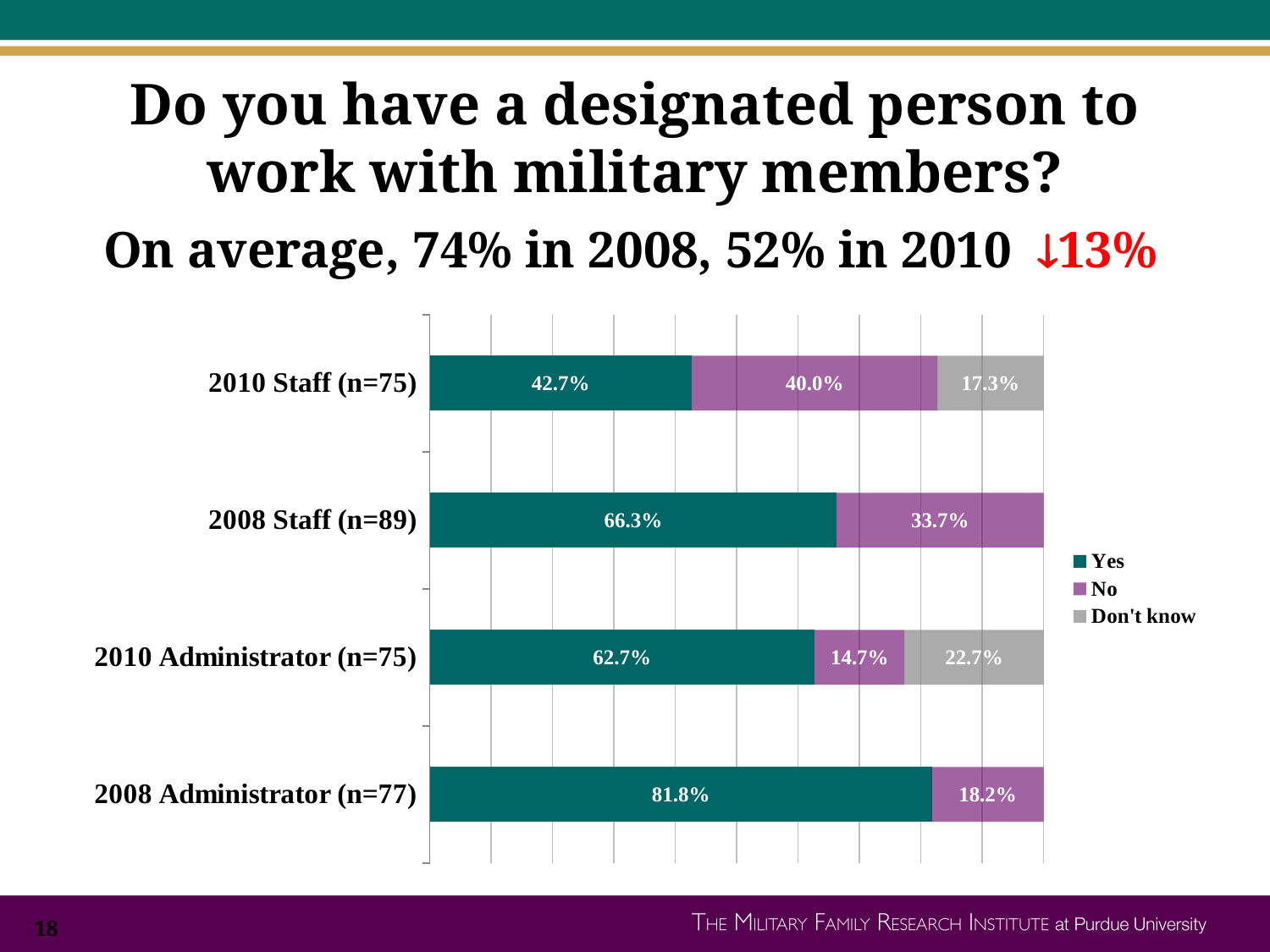
What is the Don't know value for 2010 Administrator (n=75)? 22.7% What is the difference between the Yes percentages for 2008 Administrator (n=77) and 2010 Administrator (n=75)? 19.1% Which legend entry is shown in grey? Don't know What kind of chart is shown on the slide? Stacked bar chart What percentage of 2010 Staff (n=75) answered Yes? 42.7% What percentage of 2008 Administrator (n=77) answered No? 18.2% Which is larger: the No percentage for 2010 Staff (n=75) or for 2010 Administrator (n=75)? 2010 Staff (n=75) Which category has the highest Yes percentage? 2008 Administrator (n=77) How many categories are shown on the chart? 4 Which category has the lowest Yes percentage? 2010 Staff (n=75) What percentage of 2008 Staff (n=89) answered No? 33.7% How many series does the legend list? 3